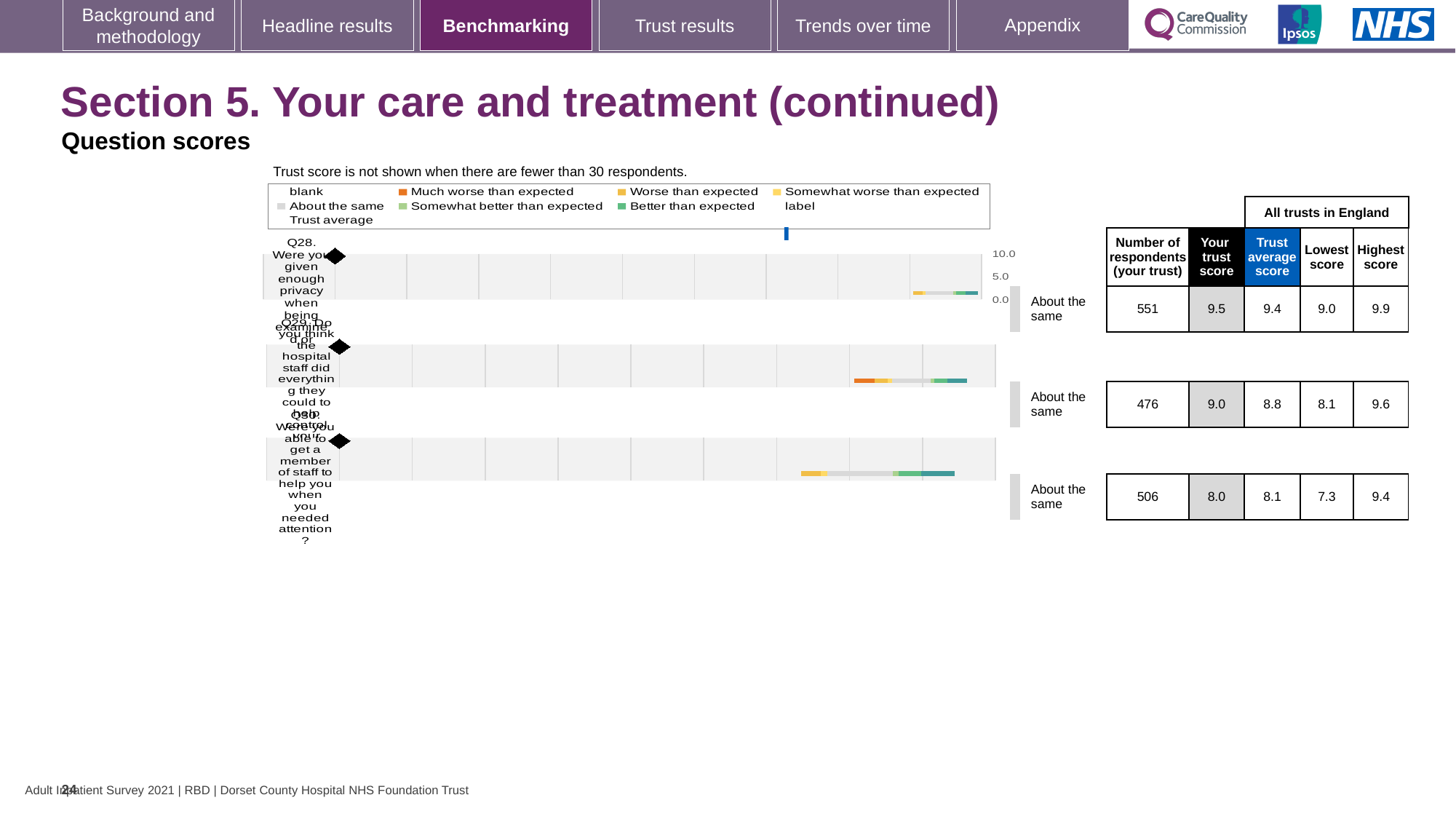
Which question has the highest trust score? Q28 How many questions are plotted on the slide? 3 What benchmark category is shown for all three questions? About the same What kind of chart is used to show the question scores? Bar chart What is the highest score across all trusts in England for Q30? 9.4 For Q29, which is larger: the trust score or the trust average score? Trust score Which question has the lowest trust score? Q30 What is the difference between the trust score and the trust average score for Q28? 0.1 What is the trust average score for Q30 (Were you able to get a member of staff to help you when you needed attention?)? 8.1 How many respondents answered Q29 (Do you think the hospital staff did everything they could to help control your pain?)? 476 What is the maximum value shown on the score axis? 10.0 What is the trust score for Q28 (Were you given enough privacy when being examined or treated?)? 9.5